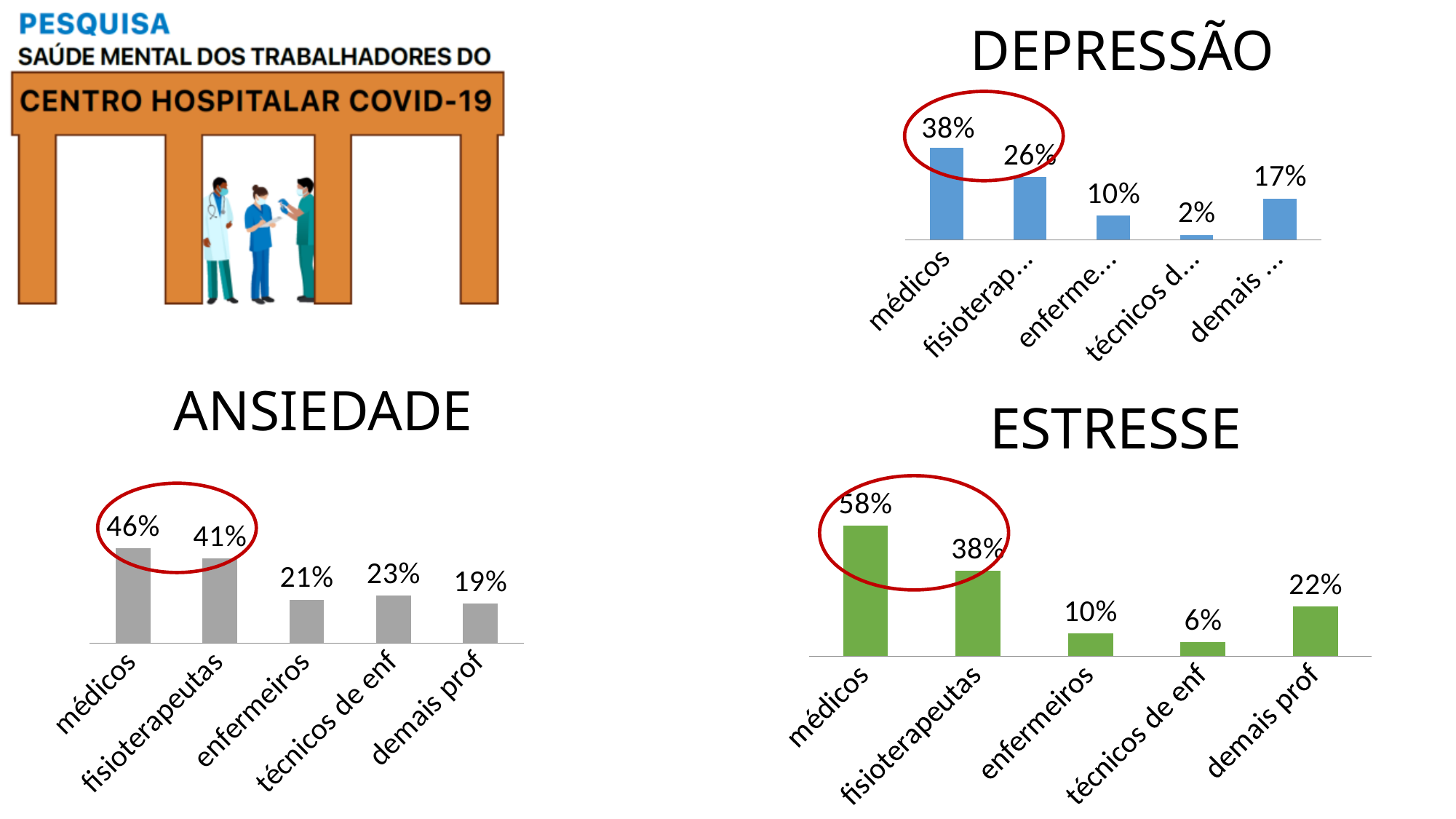
In the ESTRESSE chart, what is the value for fisioterapeutas? 38% In the DEPRESSÃO chart, which category has the lowest value? técnicos d... In the ANSIEDADE chart, which category has the highest value? médicos In the ANSIEDADE chart, how many categories are shown? 5 In the DEPRESSÃO chart, what is the value for médicos? 38% In the DEPRESSÃO chart, what is the difference between the values for médicos and fisioterap...? 12% In the ESTRESSE chart, what is the difference between the values for médicos and demais prof? 36% In the ESTRESSE chart, which category has the lowest value? técnicos de enf In the ANSIEDADE chart, which is larger, the value for enfermeiros or the value for demais prof? enfermeiros What colour are the bars in the ANSIEDADE chart? grey In the ANSIEDADE chart, what is the value for técnicos de enf? 23% What kind of chart is the ESTRESSE chart? bar chart